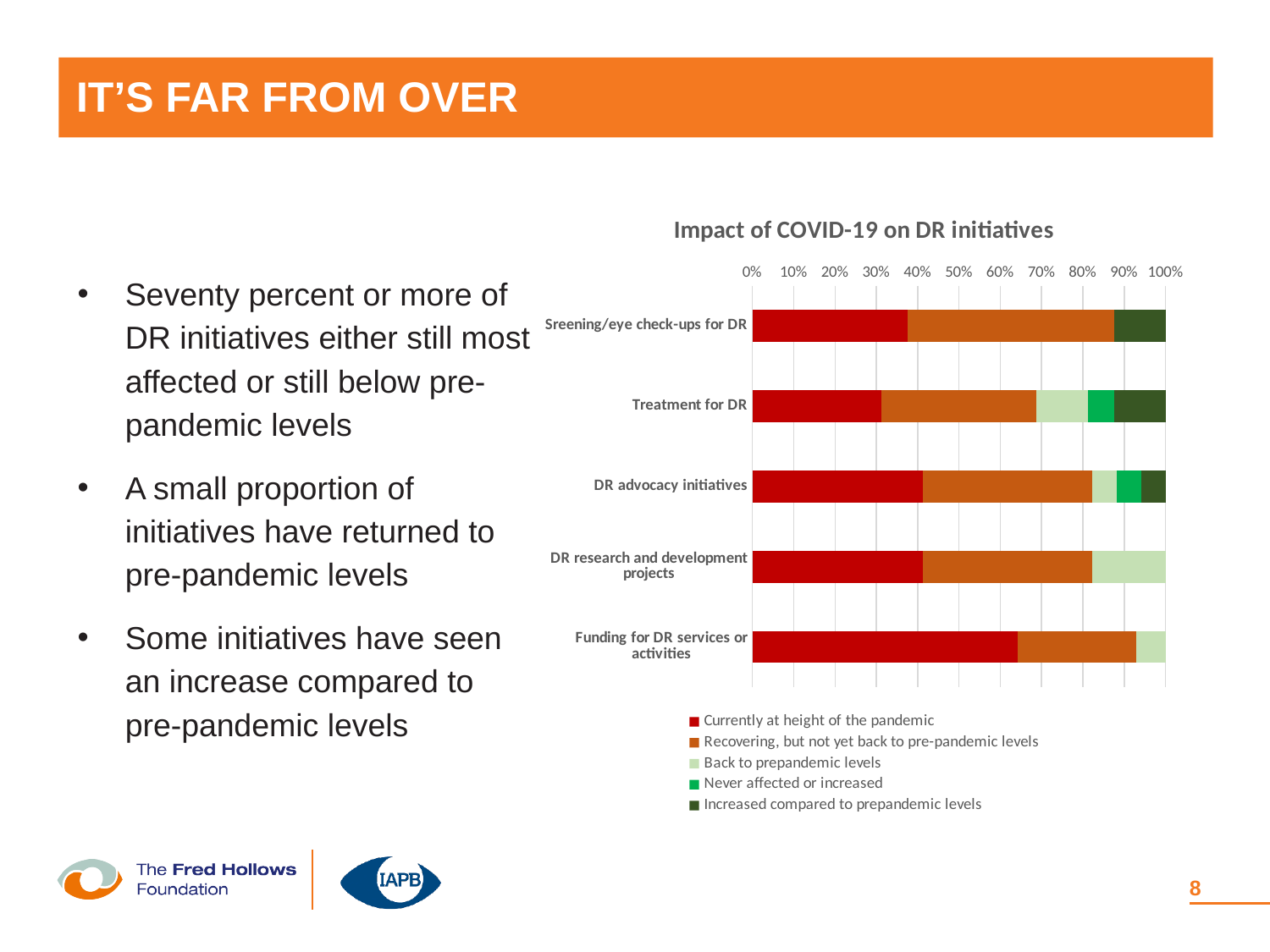
Which has a larger 'Currently at height of the pandemic' share: Funding for DR services or activities, or Sreening/eye check-ups for DR? Funding for DR services or activities Is the 'Currently at height of the pandemic' share for Funding for DR services or activities greater or less than 60%? greater What is the total of the stacked bar for DR research and development projects? 100% What is the title of the chart? Impact of COVID-19 on DR initiatives Which category has the largest 'Currently at height of the pandemic' share? Funding for DR services or activities Is the 'Currently at height of the pandemic' share for Sreening/eye check-ups for DR greater or less than 30%? greater How many DR initiative categories are plotted on the chart? 5 Which series is shown in red in the chart legend? Currently at height of the pandemic What kind of chart is shown on the slide? Stacked bar chart Is the 'Currently at height of the pandemic' share for Treatment for DR greater or less than 40%? less Which category has the smallest 'Currently at height of the pandemic' share? Treatment for DR How many series does the chart legend list? 5